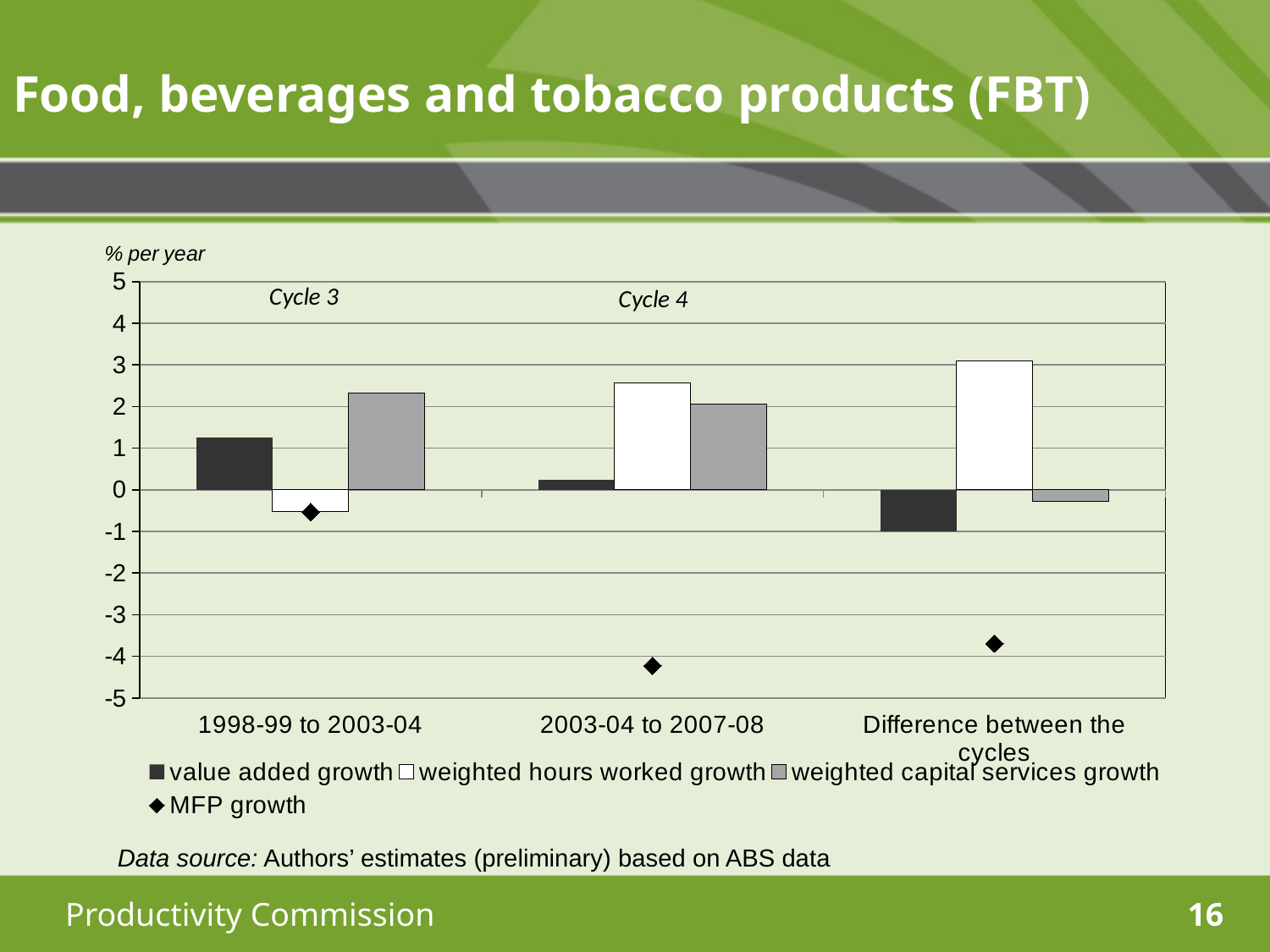
Which category has the highest weighted hours worked growth? Difference between the cycles Is the weighted capital services growth for 1998-99 to 2003-04 greater or less than 2? greater Is the value added growth for 1998-99 to 2003-04 greater or less than 2? less How many categories are shown on the x axis? 3 In 2003-04 to 2007-08, which is larger: weighted hours worked growth or value added growth? weighted hours worked growth Is the weighted hours worked growth for 2003-04 to 2007-08 greater or less than 2? greater How many series does the legend list? 4 What kind of chart is shown on the slide? combination bar and line chart (bars with MFP growth plotted as diamond markers) What unit label is shown above the y axis? % per year Which category has the lowest MFP growth? 2003-04 to 2007-08 Which is larger: value added growth for 1998-99 to 2003-04 or for 2003-04 to 2007-08? 1998-99 to 2003-04